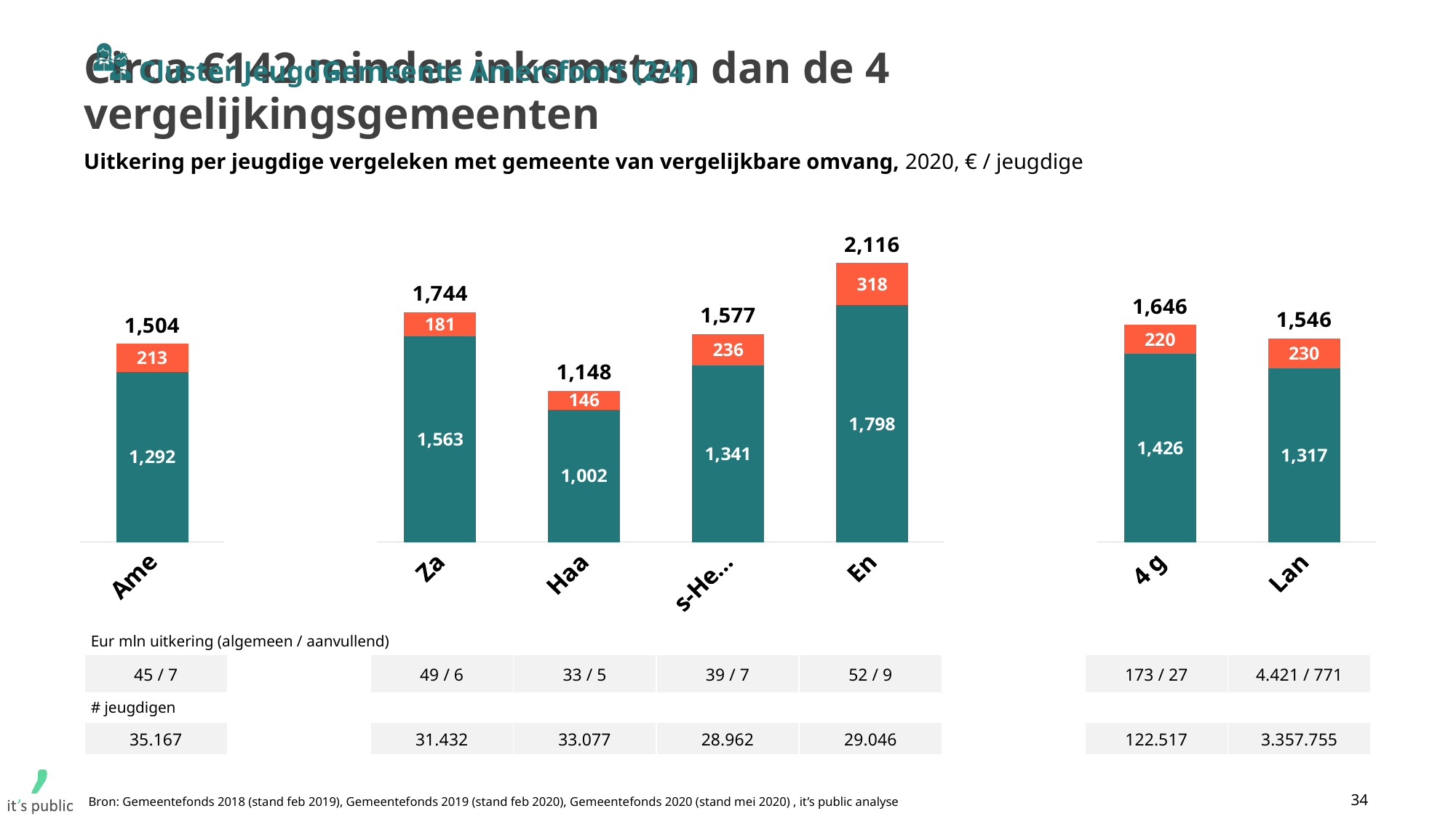
Which category has the highest total value? En What kind of chart is shown on the slide? bar chart How many categories are shown along the x axis of the chart? 7 What is the difference between the top (orange) segment for En and the top (orange) segment for Haa? 172 What is the difference between the total for En and the total for Ame? 612 What is the total value printed above the bar for 4 g? 1,646 What is the total value printed above the bar for En? 2,116 What is the value of the top (orange) segment of the bar for Lan? 230 Which has the larger total value, Za or 4 g? Za Which category has the lowest total value? Haa What is the value of the bottom (teal) segment of the bar for Ame? 1,292 What is the value of the top (orange) segment of the bar for Za? 181